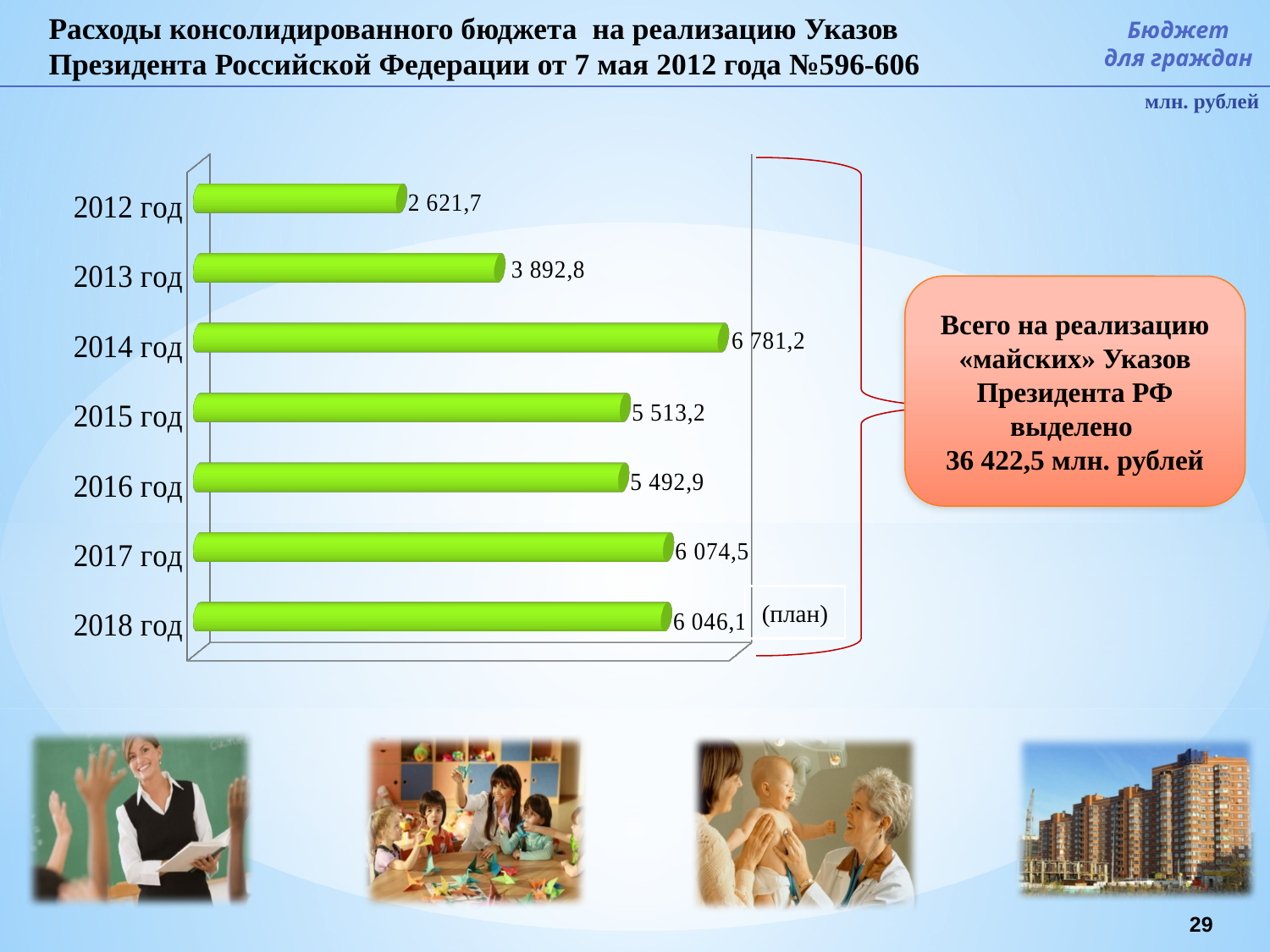
What total amount allocated for the 'May' decrees is stated in the callout box? 36 422,5 млн. рублей In what units are the chart values given? млн. рублей What is the difference between the values for 2014 год and 2012 год? 4 159,5 What is the difference between the values for 2017 год and 2018 год? 28,4 What is the value for 2016 год? 5 492,9 Which year has the highest value? 2014 год What kind of chart is shown on the slide? bar chart How many years are shown in the chart? 7 What is the planned value for 2018 год? 6 046,1 Which is larger, the value for 2015 год or the value for 2016 год? 2015 год Which year has the lowest value? 2012 год What is the value for 2012 год? 2 621,7